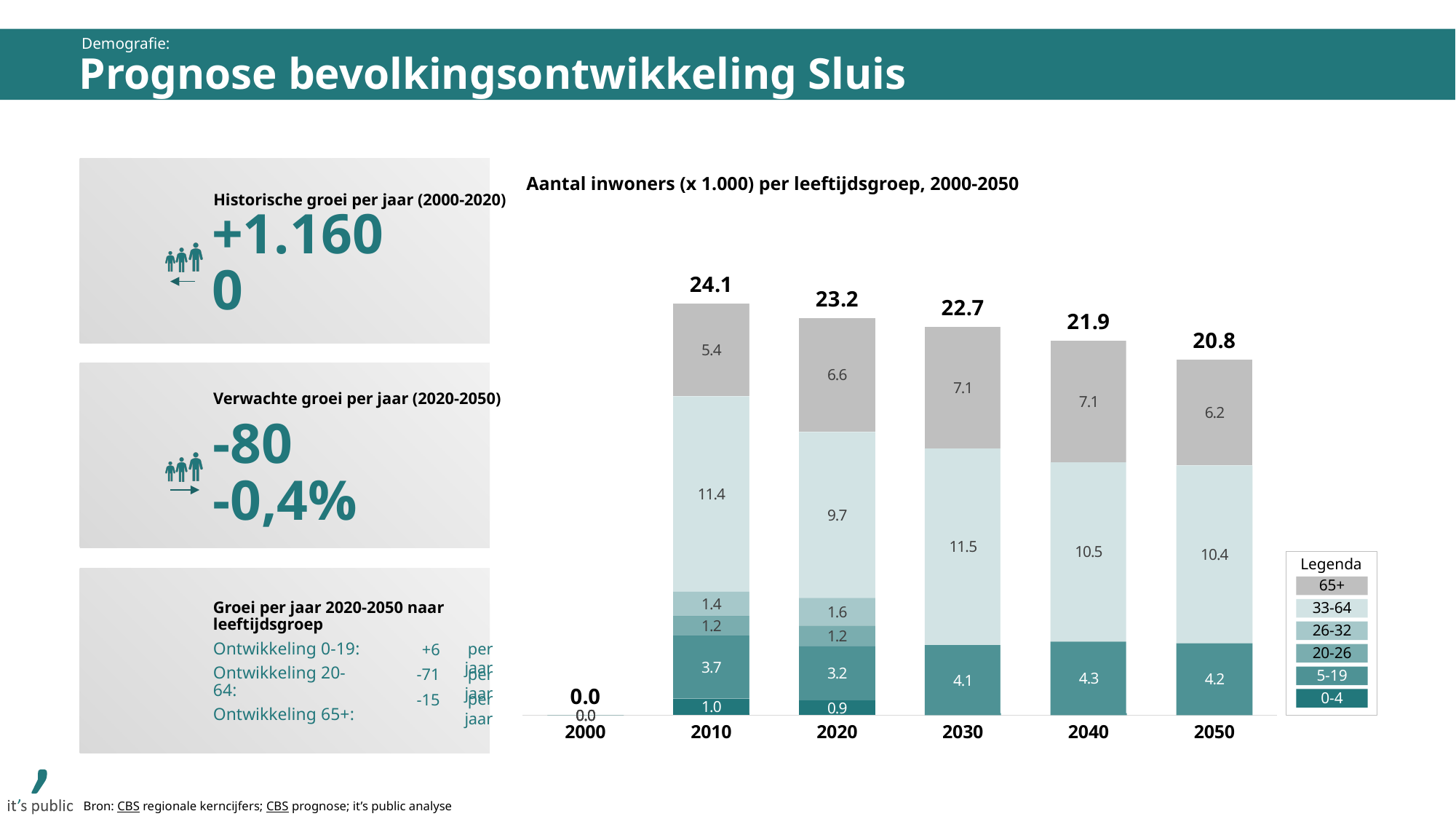
What is the value for the 0-4 age group in 2020? 0.9 How many years are shown on the x axis? 6 Which year has the highest total number of inhabitants? 2010 What kind of chart is shown? Stacked bar chart What is the value for the 33-64 age group in 2010? 11.4 Do the bar totals rise or fall from 2010 to 2050? Fall What is the difference between the total for 2010 and the total for 2050? 3.3 Is the 65+ value larger in 2030 or in 2050? 2030 Among the years 2010 to 2050, which year has the lowest total? 2050 What is the value for the 65+ age group in 2020? 6.6 How many age groups does the legend list? 6 What is the total number of inhabitants (x 1.000) shown for 2030? 22.7